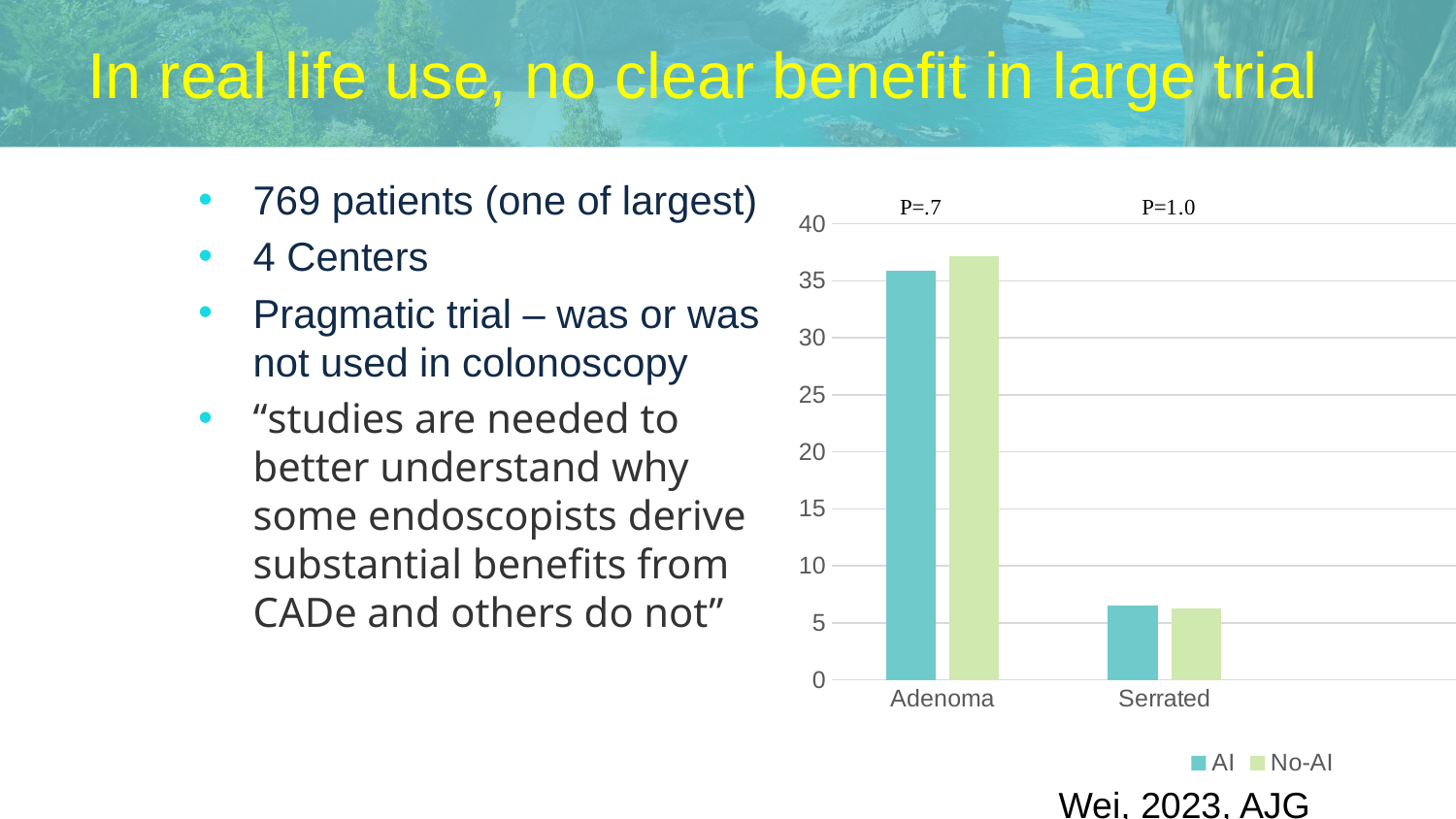
Which category has the highest bars in the chart? Adenoma Is the No-AI value for Adenoma greater or less than 35? greater Is the No-AI value for Serrated greater or less than 5? greater For the No-AI series, which category has the larger value, Adenoma or Serrated? Adenoma How many series does the chart legend list? 2 What P value is printed above the Serrated bars in the chart? P=1.0 For the AI series, which category has the larger value, Adenoma or Serrated? Adenoma Is the AI value for Adenoma greater or less than 30? greater Which category has the lowest bars in the chart? Serrated What kind of chart is shown on the slide? bar chart How many categories are shown on the x axis of the chart? 2